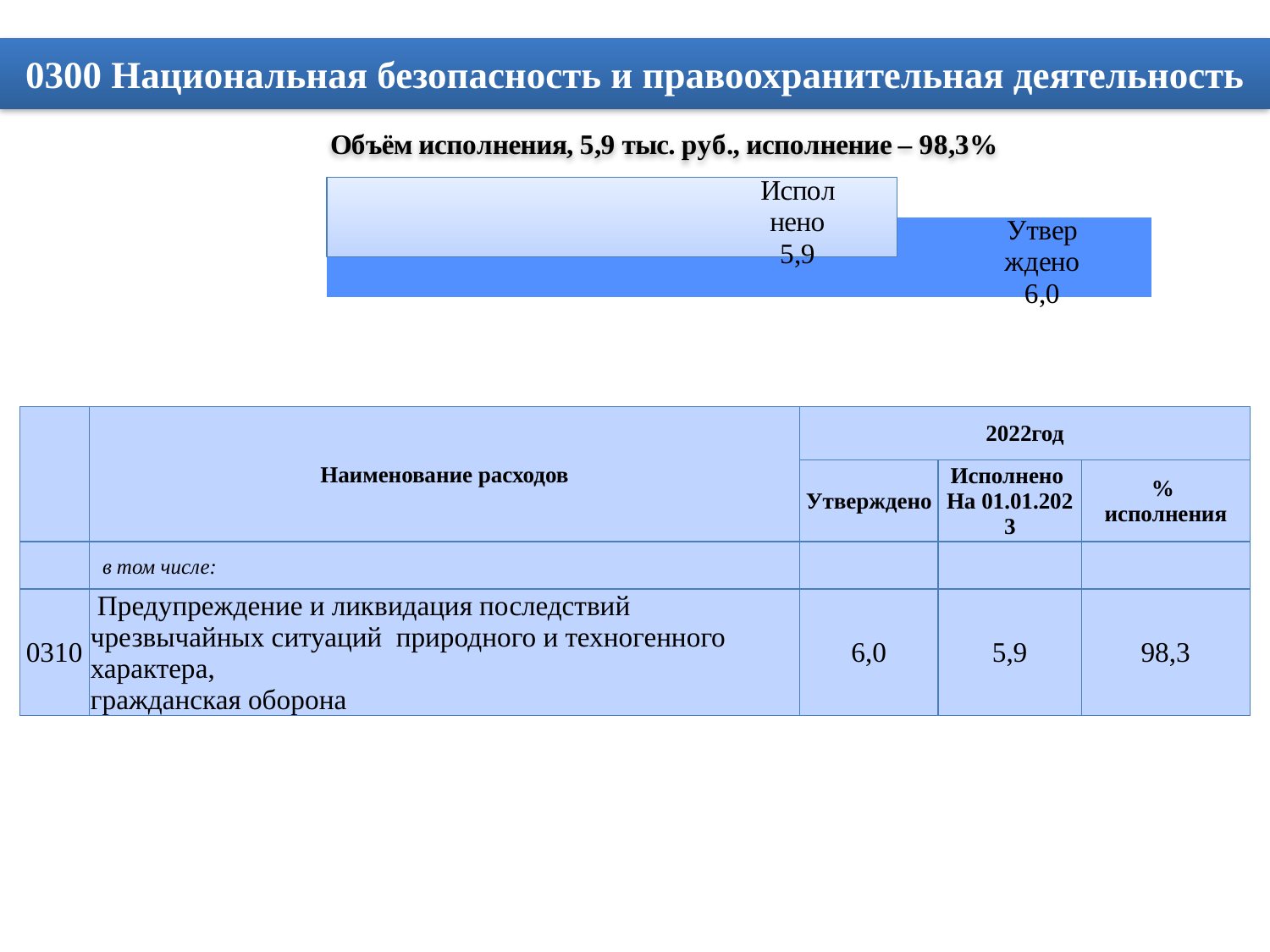
Are the bars in the chart oriented horizontally or vertically? horizontally What is the value of the bar labelled Исполнено? 5,9 Which category has the highest value in the chart? Утверждено What is the difference between the Утверждено value and the Исполнено value? 0,1 What is the value of the bar labelled Утверждено? 6,0 What is the title printed above the chart? Объём исполнения, 5,9 тыс. руб., исполнение – 98,3% What kind of chart is shown on the slide? bar chart How many bars are plotted in the chart? 2 Which bar has the higher value, Исполнено or Утверждено? Утверждено Which category has the lowest value in the chart? Исполнено